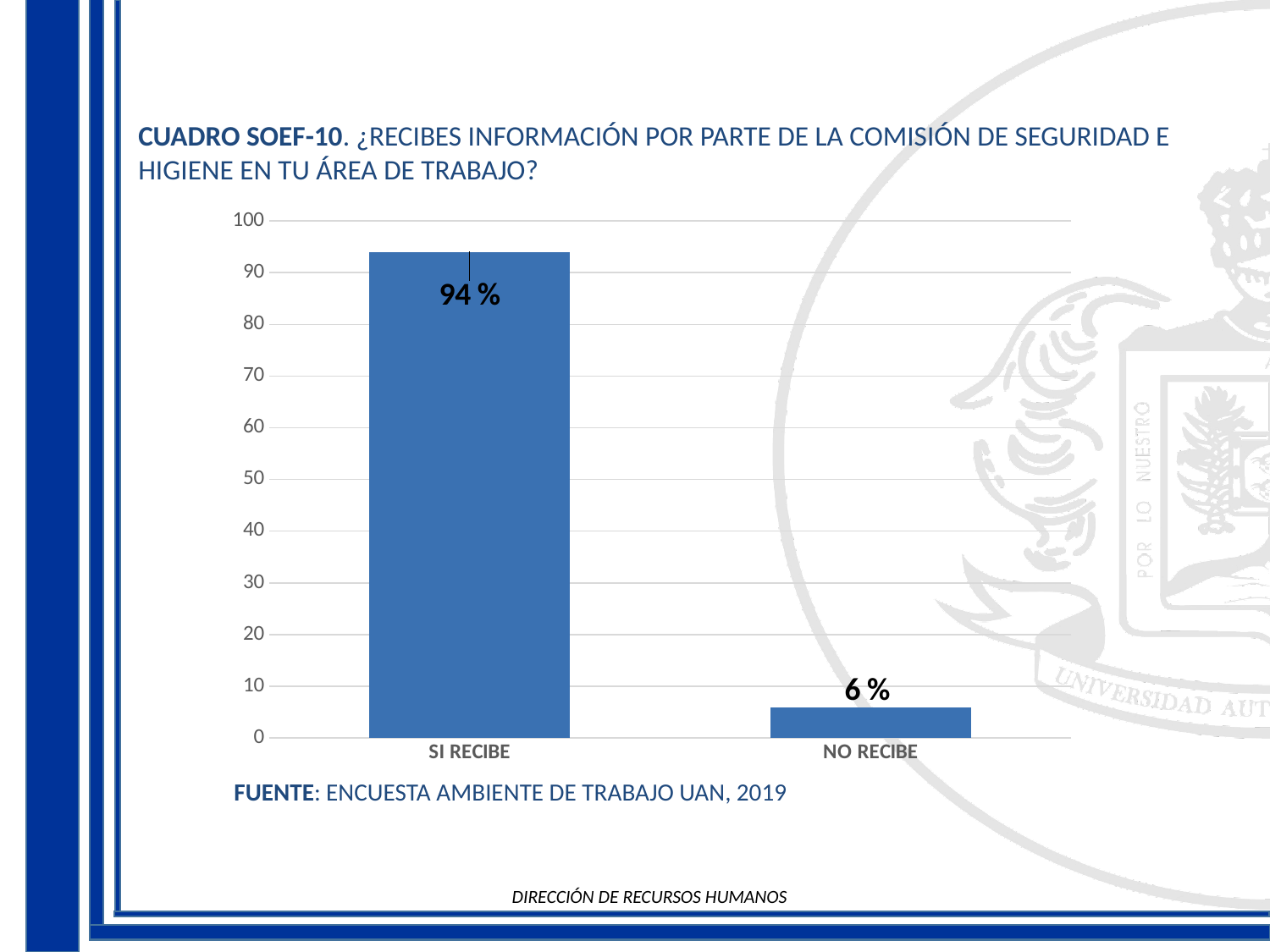
What is the source cited below the chart? ENCUESTA AMBIENTE DE TRABAJO UAN, 2019 What is the value for SI RECIBE? 94 % Which category has the lowest value? NO RECIBE What kind of chart is shown on the slide? bar chart Which is larger, the value for SI RECIBE or the value for NO RECIBE? SI RECIBE What is the value for NO RECIBE? 6 % Which category has the highest value? SI RECIBE Is the value for SI RECIBE greater or less than 50? greater What is the difference between the values for SI RECIBE and NO RECIBE? 88 % Is the value for NO RECIBE greater or less than 10? less What is the highest value shown on the y axis? 100 How many categories are shown on the x axis? 2